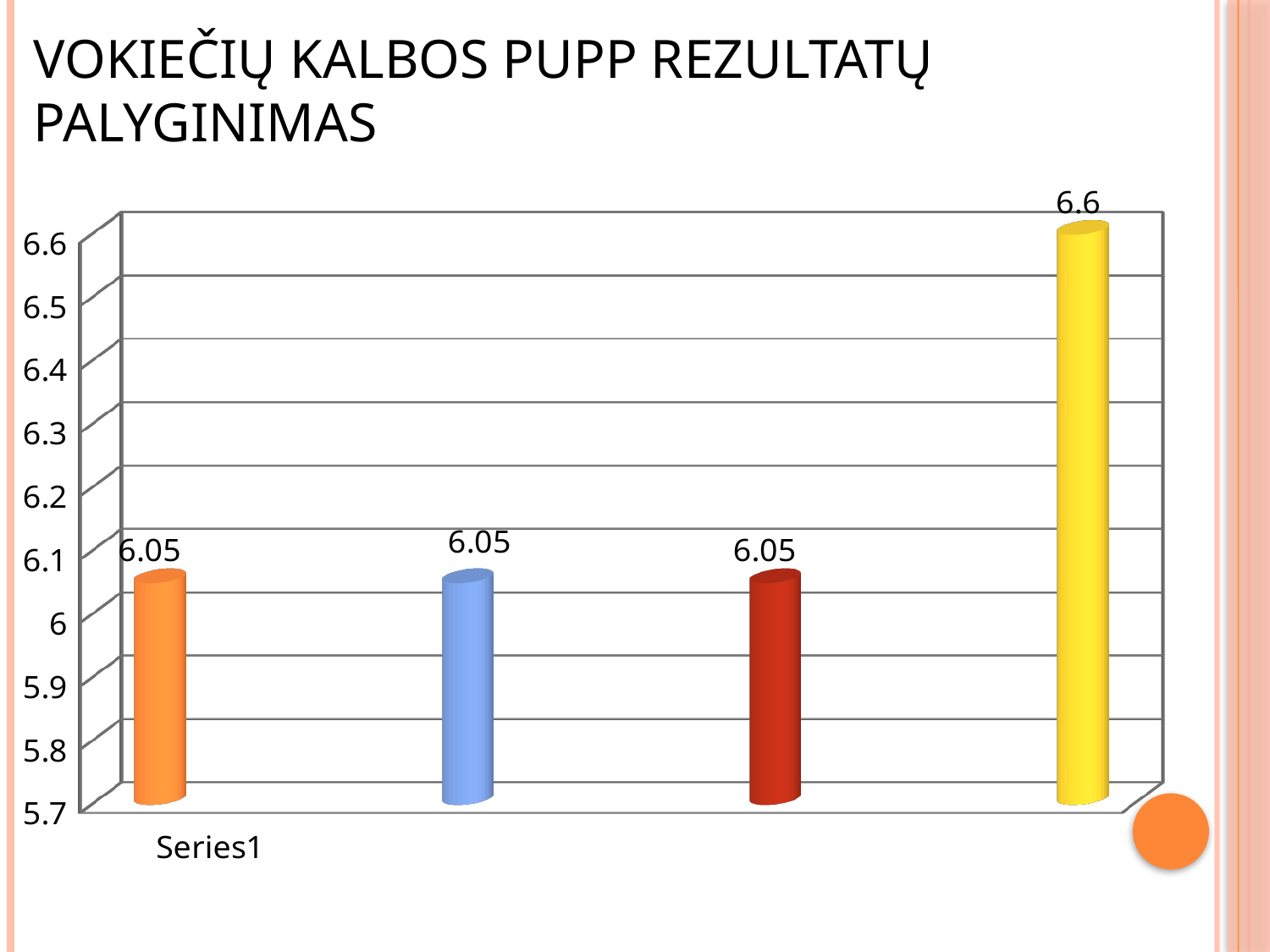
What kind of chart is shown on the slide? Bar chart Which is larger, the value of the yellow bar or the value of the red bar? The yellow bar Is the value of the blue bar greater or less than 6.1? less What is the title of the slide? VOKIEČIŲ KALBOS PUPP REZULTATŲ PALYGINIMAS What is the difference between the yellow bar's value and the orange bar's value? 0.55 Is the value of the yellow bar greater or less than 6.5? greater What is the value shown on the red (third) bar? 6.05 What is the value shown on the blue (second) bar? 6.05 What is the value shown on the orange (first) bar? 6.05 What is the value shown on the yellow (fourth) bar? 6.6 How many bars are plotted in the chart? 4 Which bar has the highest value? The yellow (fourth) bar